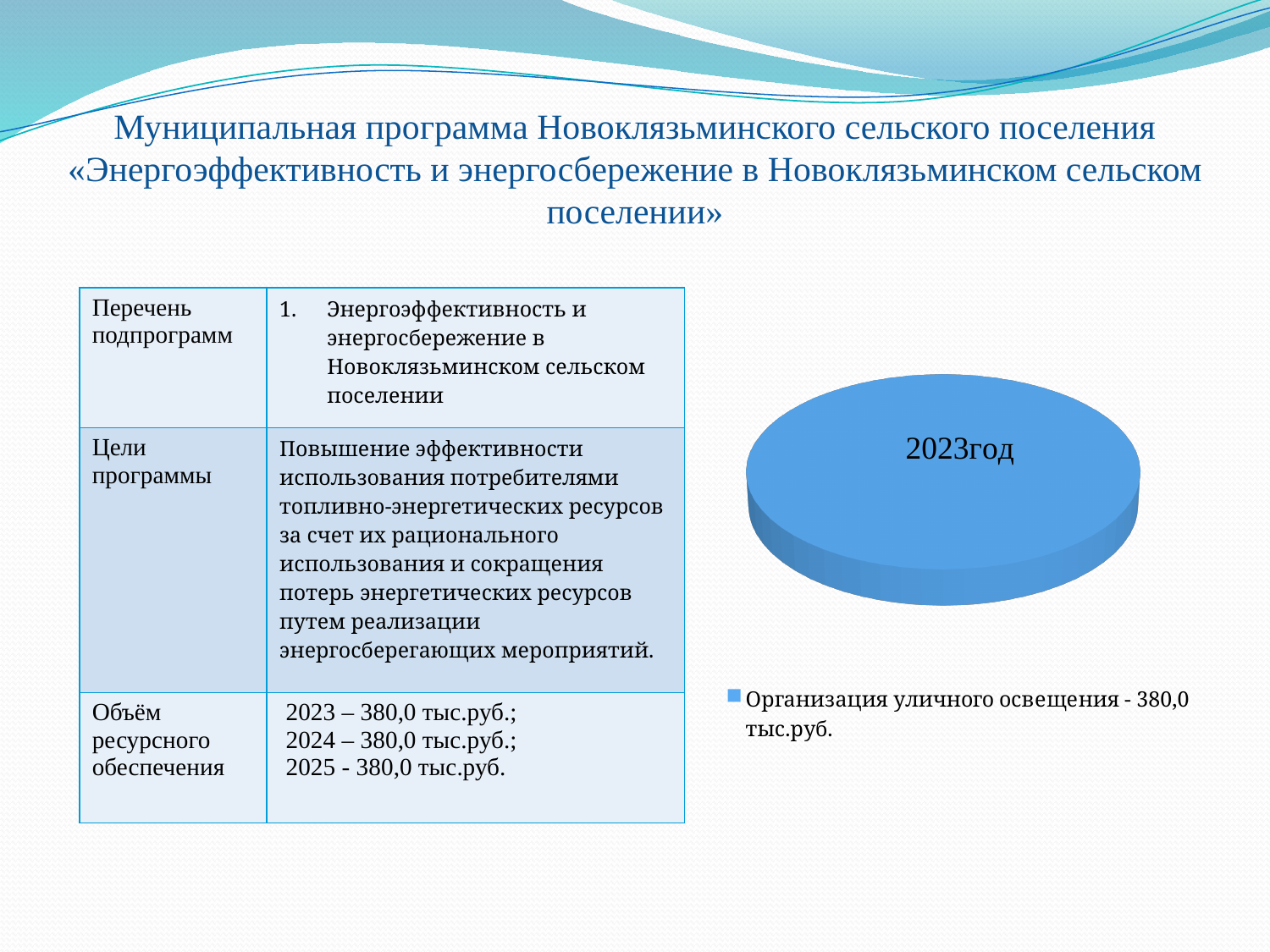
How many entries does the pie chart's legend list? 1 What value is given for Организация уличного освещения in the pie chart's legend? 380,0 тыс.руб. How many slices does the pie chart have? 1 What share of the pie chart does the slice for Организация уличного освещения take up? 100% What kind of chart is shown on the slide? pie chart What category does the legend of the pie chart name? Организация уличного освещения - 380,0 тыс.руб. What is the title of the pie chart? 2023год